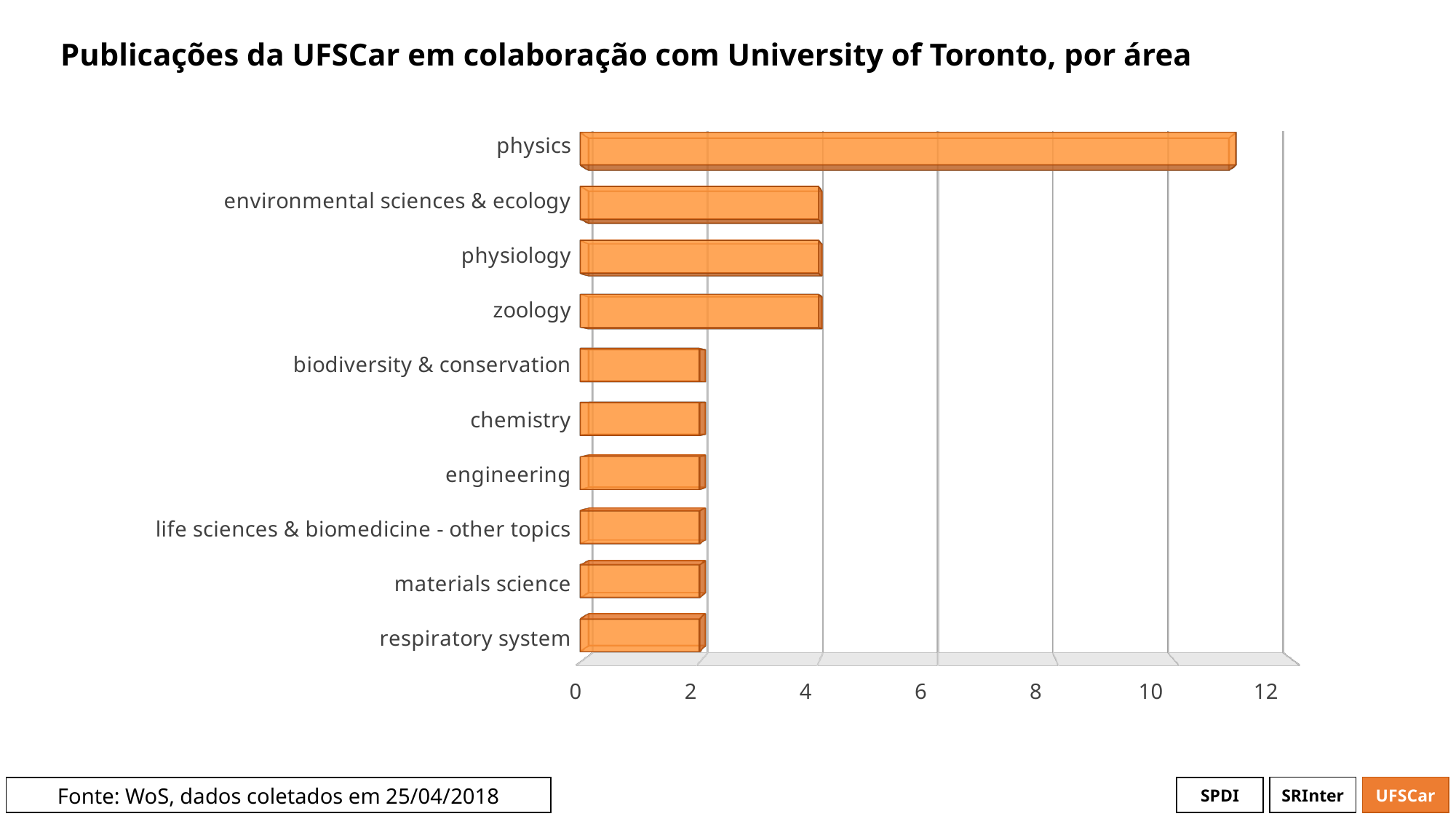
Is the value for physics greater or less than 10? greater What is the title of the chart? Publicações da UFSCar em colaboração com University of Toronto, por área What kind of chart is shown on the slide? bar chart Which area has the highest number of publications? physics Is the value for respiratory system greater or less than 4? less Is the value for physics greater or less than 12? less Which is larger, the value for environmental sciences & ecology or the value for engineering? environmental sciences & ecology What is the value for physiology? 4 How many areas (categories) are shown in the chart? 10 What is the difference between the value for zoology and the value for materials science? 2 What is the value for chemistry? 2 What is the value for zoology? 4